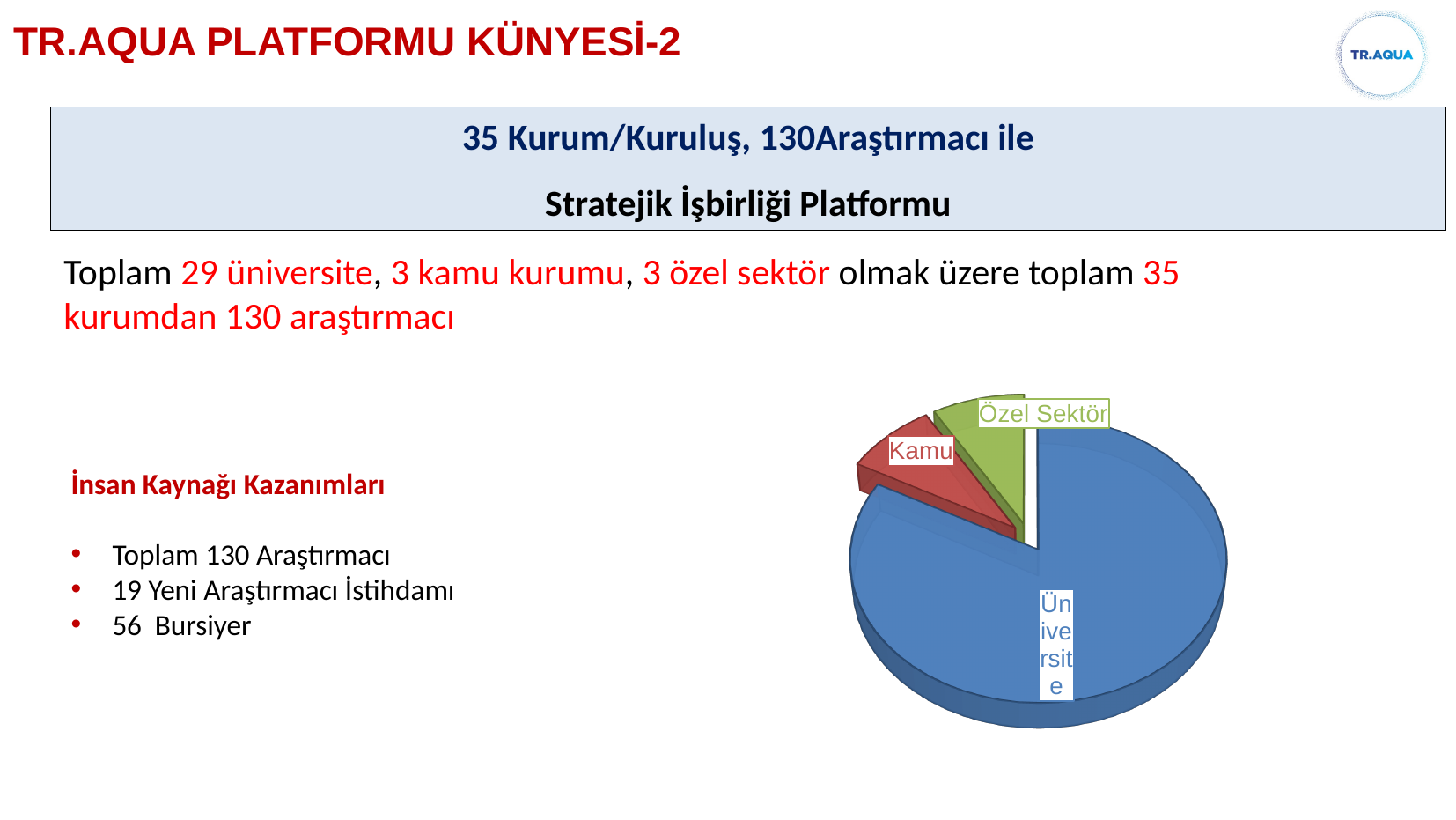
Which is larger in the pie chart, Üniversite or Kamu? Üniversite Which slice of the pie chart is the largest? Üniversite Does the Üniversite slice make up more or less than half of the pie chart? more How many slices does the pie chart have? 3 What colour is the Özel Sektör slice in the pie chart? green What colour is the Kamu slice in the pie chart? red Which is larger in the pie chart, Üniversite or Özel Sektör? Üniversite What kind of chart is shown on the slide? pie chart